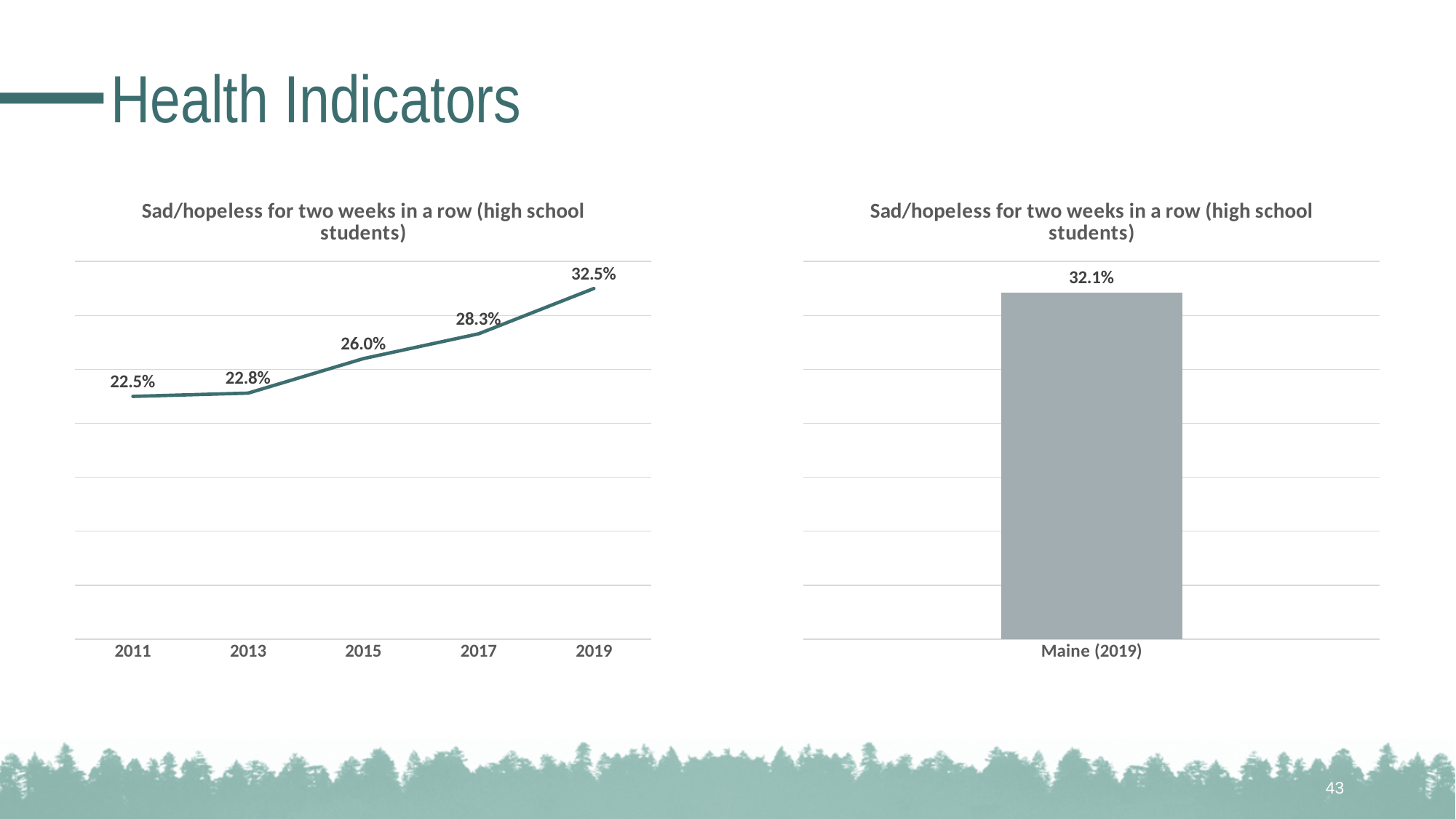
In the left chart, which year has the highest value? 2019 In the left chart, what is the value for 2019? 32.5% How many data points are plotted in the left chart? 5 In the left chart, what is the difference between the 2017 and 2015 values? 2.3% In the right chart, what is the value for Maine (2019)? 32.1% In the left chart, what is the value for 2015? 26.0% What kind of chart is the right chart? Bar chart In the left chart, which year has the lowest value? 2011 In the left chart, do the values rise or fall from 2011 to 2019? Rise In the left chart, what is the value for 2011? 22.5% In the left chart, what is the difference between the 2019 and 2011 values? 10.0% Which is larger: the 2019 value in the left chart or the Maine (2019) value in the right chart? The 2019 value in the left chart (32.5%)